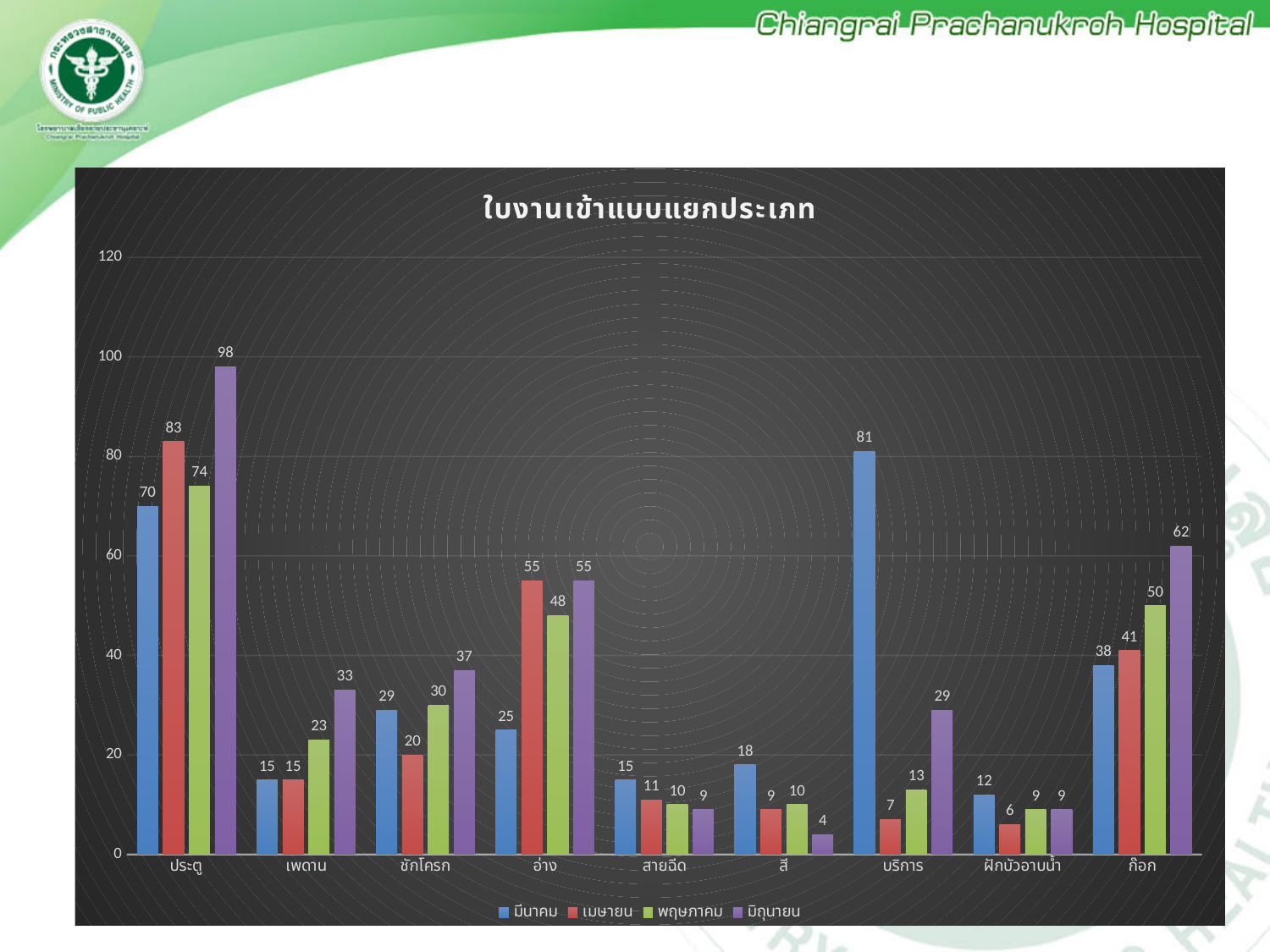
Which is larger for อ่าง: the เมษายน value or the พฤษภาคม value? เมษายน What is the value for ประตู in the มิถุนายน series? 98 How many series does the legend list? 4 What is the value for บริการ in the มีนาคม series? 81 How many categories are shown on the x axis? 9 What is the value for ก๊อก in the พฤษภาคม series? 50 Which category has the lowest value in the มิถุนายน series? สี What is the difference between the มิถุนายน and มีนาคม values for ก๊อก? 24 Which colour represents the มิถุนายน series in the legend? purple What kind of chart is shown on the slide? bar chart What is the title of the chart? ใบงานเข้าแบบแยกประเภท Which category has the highest value in the เมษายน series? ประตู